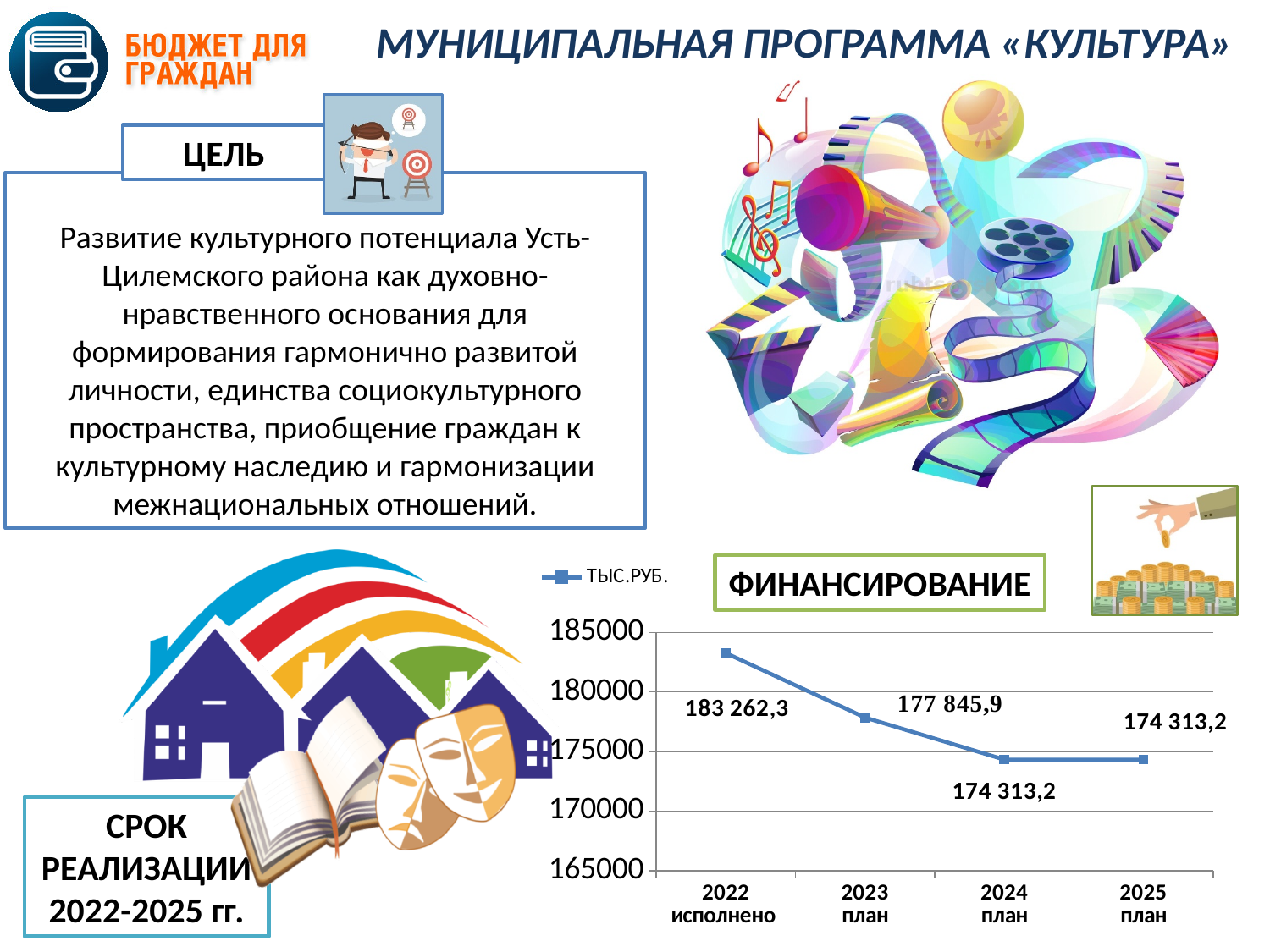
Is the value for 2023 план greater or less than 180000? less Which is larger, the value for 2022 исполнено or the value for 2025 план? 2022 исполнено What is the difference between the values for 2023 план and 2024 план? 3 532,7 What is the value for 2025 план? 174 313,2 What is the difference between the values for 2022 исполнено and 2023 план? 5 416,4 Do the values rise or fall from 2022 to 2024 along the x axis? fall Which year has the highest value on the chart? 2022 исполнено What is the value for 2023 план? 177 845,9 What is the value for 2024 план? 174 313,2 What type of chart is shown under the heading ФИНАНСИРОВАНИЕ? line chart How many data points are plotted on the chart? 4 What is the value for 2022 исполнено? 183 262,3